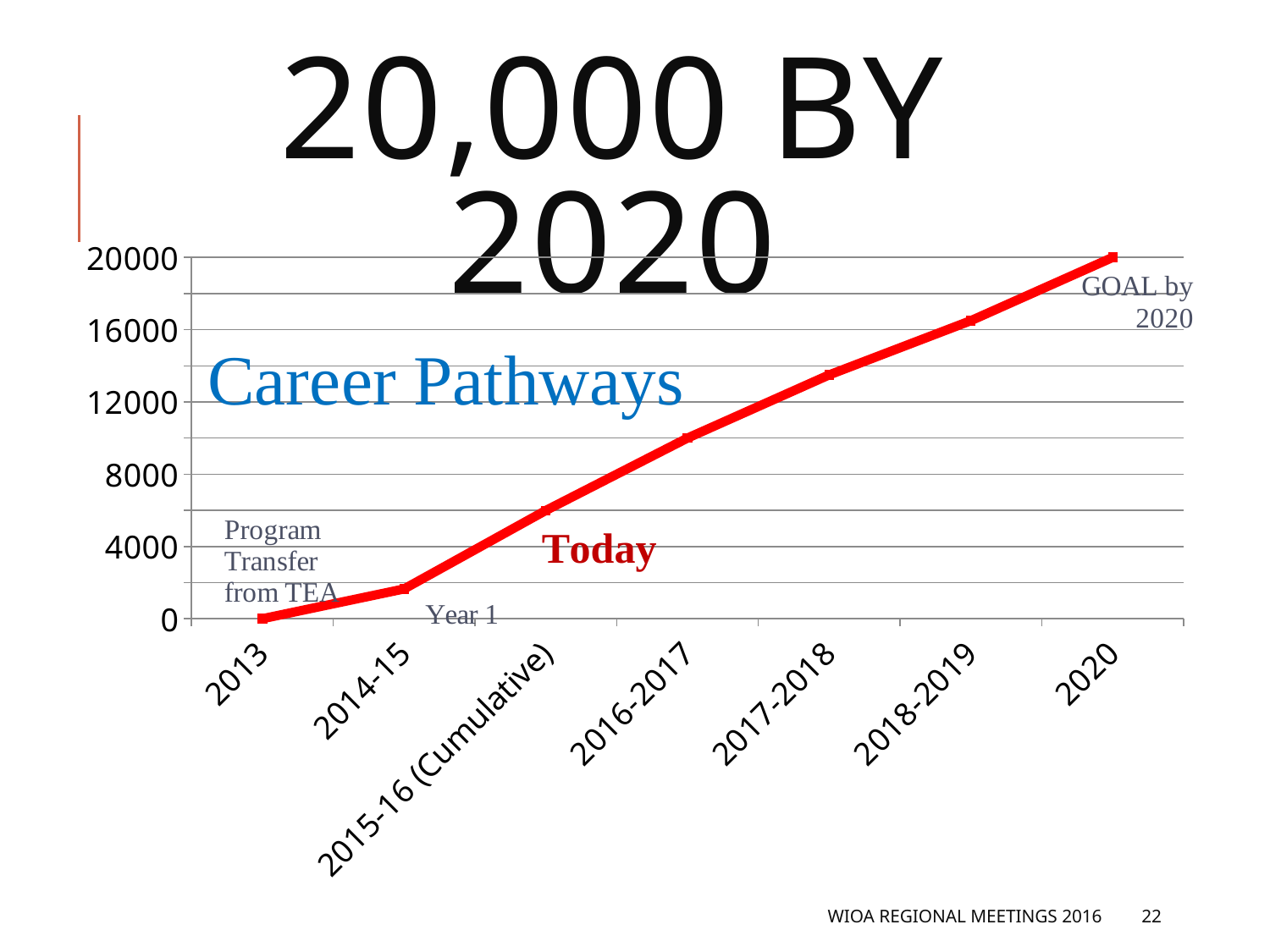
What label is placed next to the 2020 data point? GOAL by 2020 What kind of chart is shown on the slide? line chart Is the value for 2016-2017 greater or less than 8000? greater Is the value for 2014-15 greater or less than 4000? less What is the value plotted for 2013? 0 Is the value for 2015-16 (Cumulative) greater or less than 8000? less Do the values rise or fall from 2013 to 2020? rise How many data points are plotted on the line? 7 Which category has the highest value? 2020 What is the value plotted for 2020? 20000 Which is larger, the value for 2018-2019 or the value for 2016-2017? 2018-2019 Which category has the lowest value? 2013